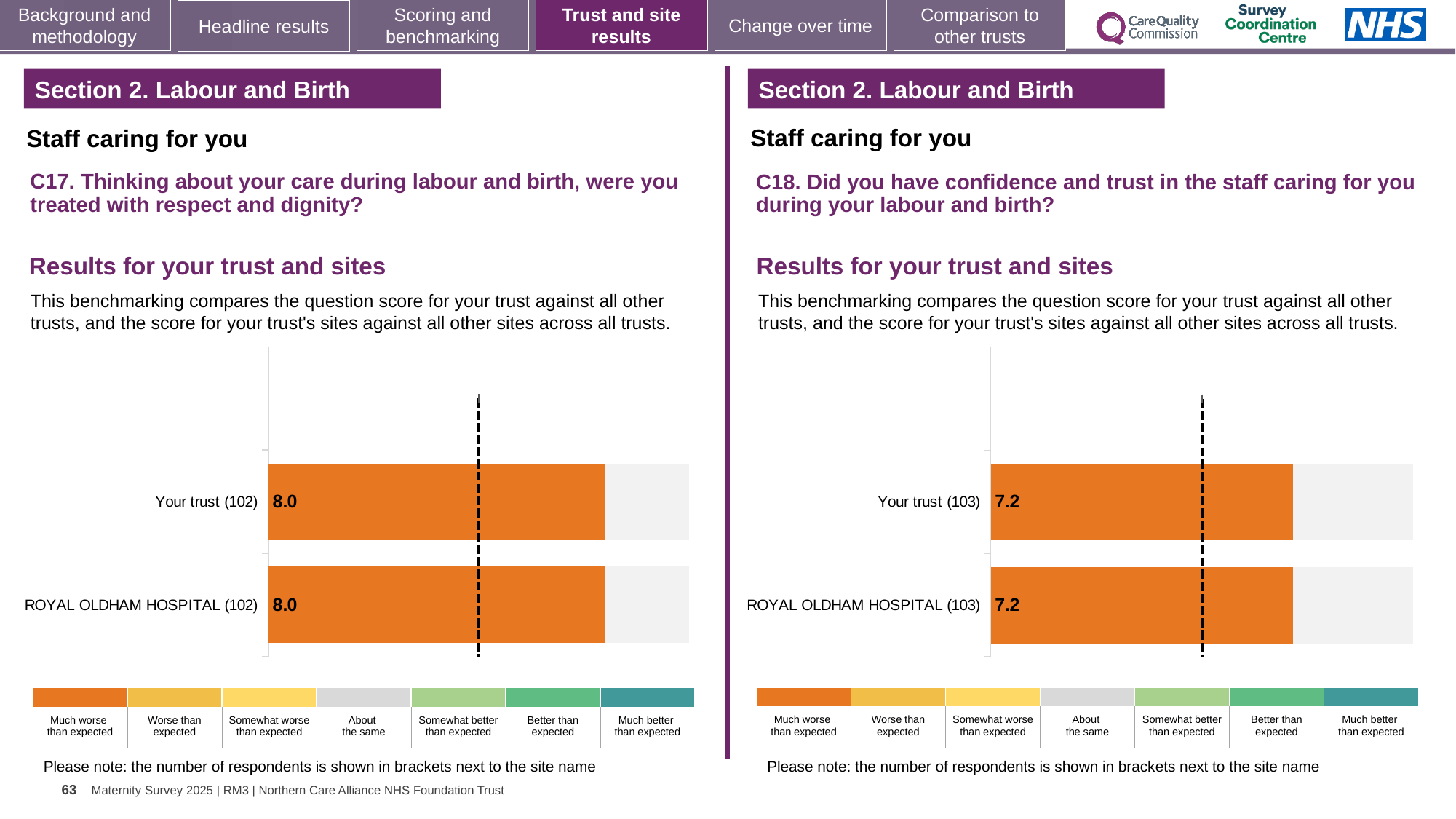
How many bars are plotted in the C18 chart on the right? 2 In the C18 chart on the right, what is the score for ROYAL OLDHAM HOSPITAL? 7.2 In the C18 chart on the right, what is the difference between the score for Your trust and the score for ROYAL OLDHAM HOSPITAL? 0.0 According to the legend below the C18 chart on the right, which category does the orange colour of the bars represent? Much worse than expected What type of chart is used for the C17 results on the left? Bar chart In the C18 chart on the right, what is the score for Your trust? 7.2 In the C18 chart on the right, how many respondents are shown in brackets for ROYAL OLDHAM HOSPITAL? 103 In the C17 chart on the left, what is the score for Your trust? 8.0 How many bars are plotted in the C17 chart on the left? 2 In the C17 chart on the left, how many respondents are shown in brackets for Your trust? 102 In the C17 chart on the left, what is the score for ROYAL OLDHAM HOSPITAL? 8.0 In the C17 chart on the left, what is the difference between the score for Your trust and the score for ROYAL OLDHAM HOSPITAL? 0.0